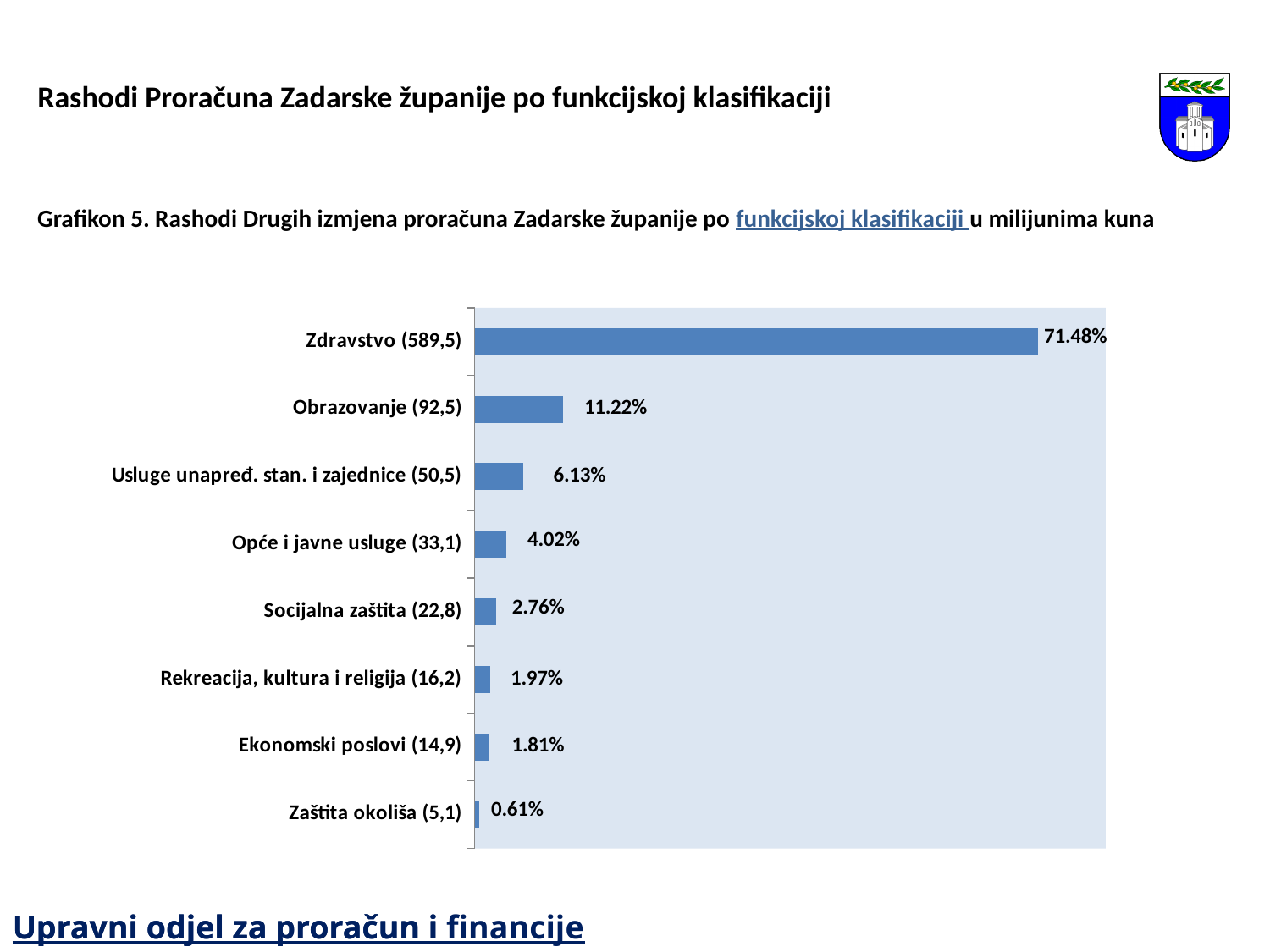
What percentage is shown for Zaštita okoliša (5,1)? 0.61% What unit does the chart caption say the values in parentheses are expressed in? Millions of kuna (milijunima kuna) What is the difference in percentage points between Obrazovanje (92,5) and Usluge unapređ. stan. i zajednice (50,5)? 5.09 Which category has the lowest percentage? Zaštita okoliša (5,1) Which category has the highest percentage? Zdravstvo (589,5) Which has a larger percentage, Opće i javne usluge (33,1) or Rekreacija, kultura i religija (16,2)? Opće i javne usluge (33,1) What is the difference in percentage points between Ekonomski poslovi (14,9) and Zaštita okoliša (5,1)? 1.20 How many categories are shown in the chart? 8 What percentage is shown for Zdravstvo (589,5)? 71.48% What percentage is shown for Socijalna zaštita (22,8)? 2.76% What kind of chart is shown on the slide? Bar chart What percentage is shown for Obrazovanje (92,5)? 11.22%